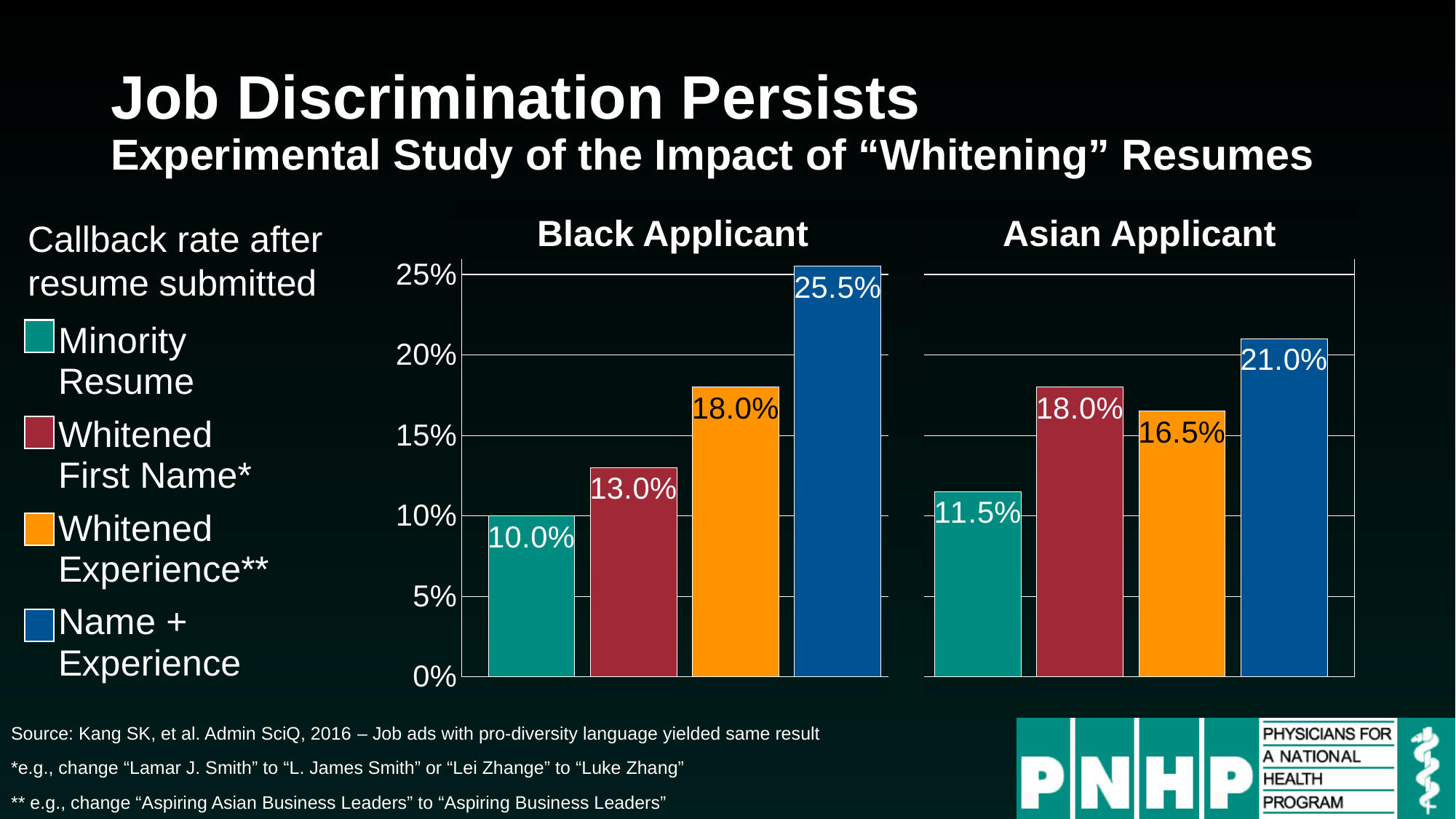
In the Asian Applicant chart, what is the difference between the Whitened First Name and Whitened Experience callback rates? 1.5% How many bars are shown in the Asian Applicant chart? 4 Which is larger: the Whitened First Name callback rate for Black applicants or for Asian applicants? Asian applicants How many resume types does the legend list? 4 In the Black Applicant chart, what is the difference between the Name + Experience callback rate and the Minority Resume callback rate? 15.5% In the Asian Applicant chart, what is the callback rate for Name + Experience? 21.0% In the Asian Applicant chart, what is the callback rate for Whitened Experience? 16.5% In the Black Applicant chart, is the Whitened First Name callback rate greater or less than 15%? less What type of chart is used to show the callback rates? Bar chart In the Black Applicant chart, which resume type has the highest callback rate? Name + Experience In the Asian Applicant chart, which resume type has the lowest callback rate? Minority Resume In the Black Applicant chart, what is the callback rate for the Minority Resume? 10.0%